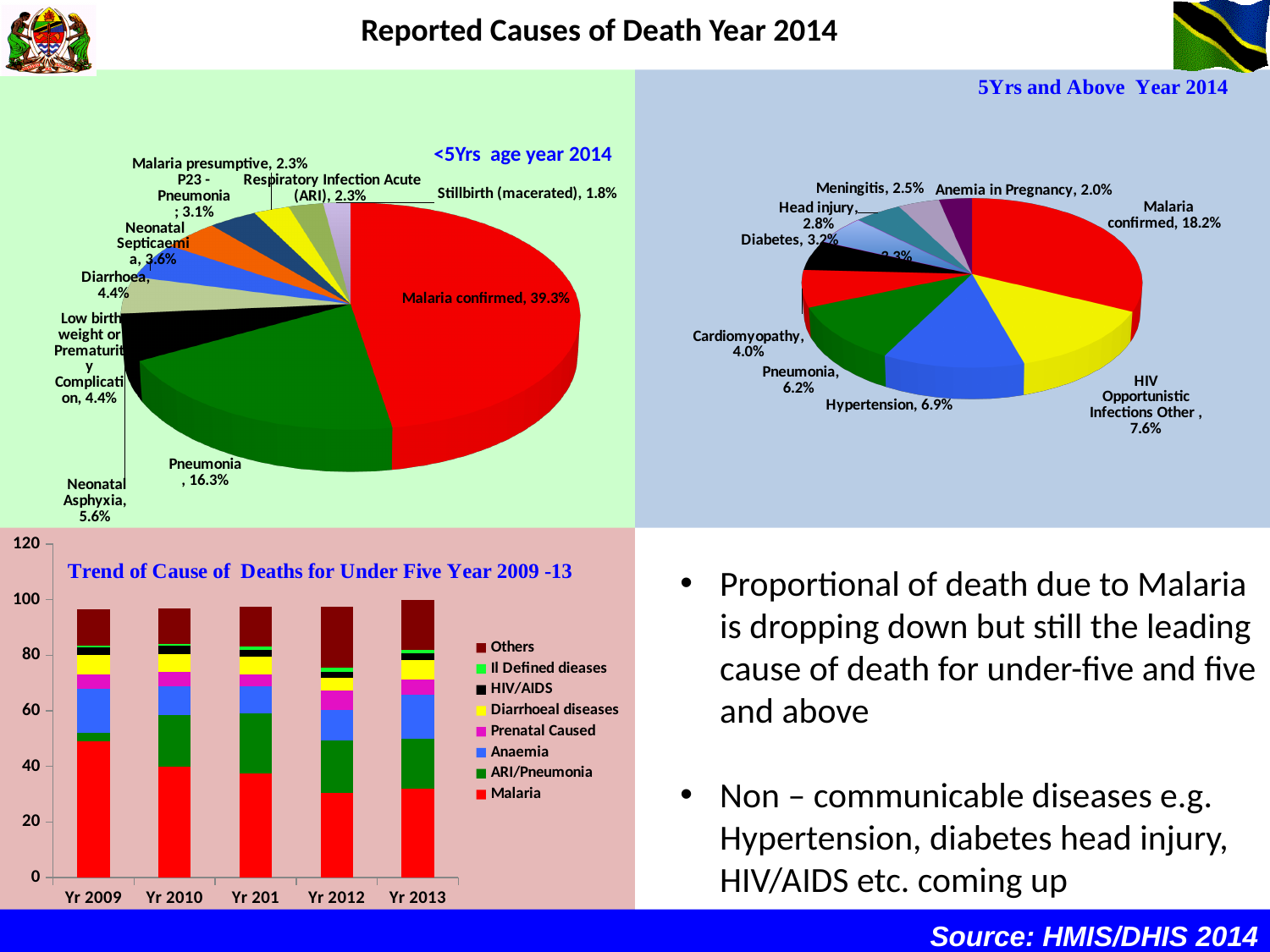
In the <5Yrs age year 2014 pie chart, what share of deaths is attributed to Malaria confirmed? 39.3% In the <5Yrs age year 2014 pie chart, what is the value for Neonatal Asphyxia? 5.6% In the 5Yrs and Above Year 2014 pie chart, which is larger, Pneumonia or Cardiomyopathy? Pneumonia In the 5Yrs and Above Year 2014 pie chart, what is the value for Hypertension? 6.9% In the <5Yrs age year 2014 pie chart, what is the value for Pneumonia? 16.3% How many series does the legend of the Trend of Cause of Deaths for Under Five Year 2009-13 chart list? 8 In the 5Yrs and Above Year 2014 pie chart, what is the value for Diabetes? 3.2% In the <5Yrs age year 2014 pie chart, what is the difference between Malaria confirmed and Pneumonia? 23.0% In the Trend of Cause of Deaths for Under Five Year 2009-13 chart, is the Malaria value for Yr 2009 greater or less than 40? greater In the <5Yrs age year 2014 pie chart, which cause has the largest share? Malaria confirmed In the 5Yrs and Above Year 2014 pie chart, what is the value for Malaria confirmed? 18.2% What kind of chart is the Trend of Cause of Deaths for Under Five Year 2009-13 chart? Stacked bar chart